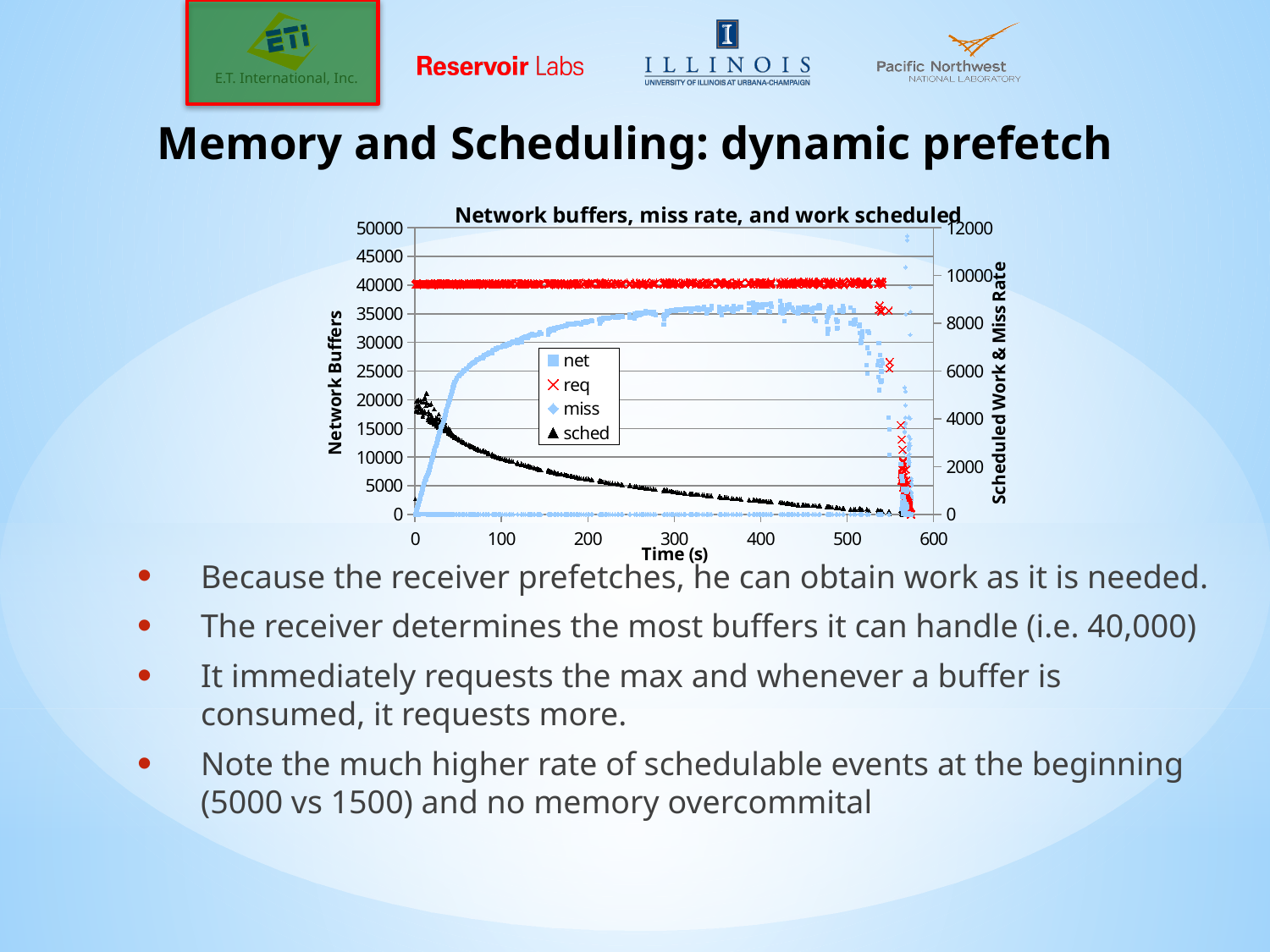
What is the maximum value shown on the right y axis of the chart? 12000 Does the net series rise or fall as time increases from 0 to 300 s? rise What is the label of the left y axis of the chart? Network Buffers What is the label of the right y axis of the chart? Scheduled Work & Miss Rate What is the maximum value shown on the left y axis of the chart? 50000 What is the label of the x axis of the chart? Time (s) How many series does the chart's legend list? 4 On the left axis, is the value of the req series at 300 s greater or less than 35000? greater Does the sched series rise or fall as time increases from 0 to 500 s? fall What kind of chart is shown on the slide? scatter chart What is the title of the chart? Network buffers, miss rate, and work scheduled What are the series names listed in the chart's legend? net, req, miss, sched